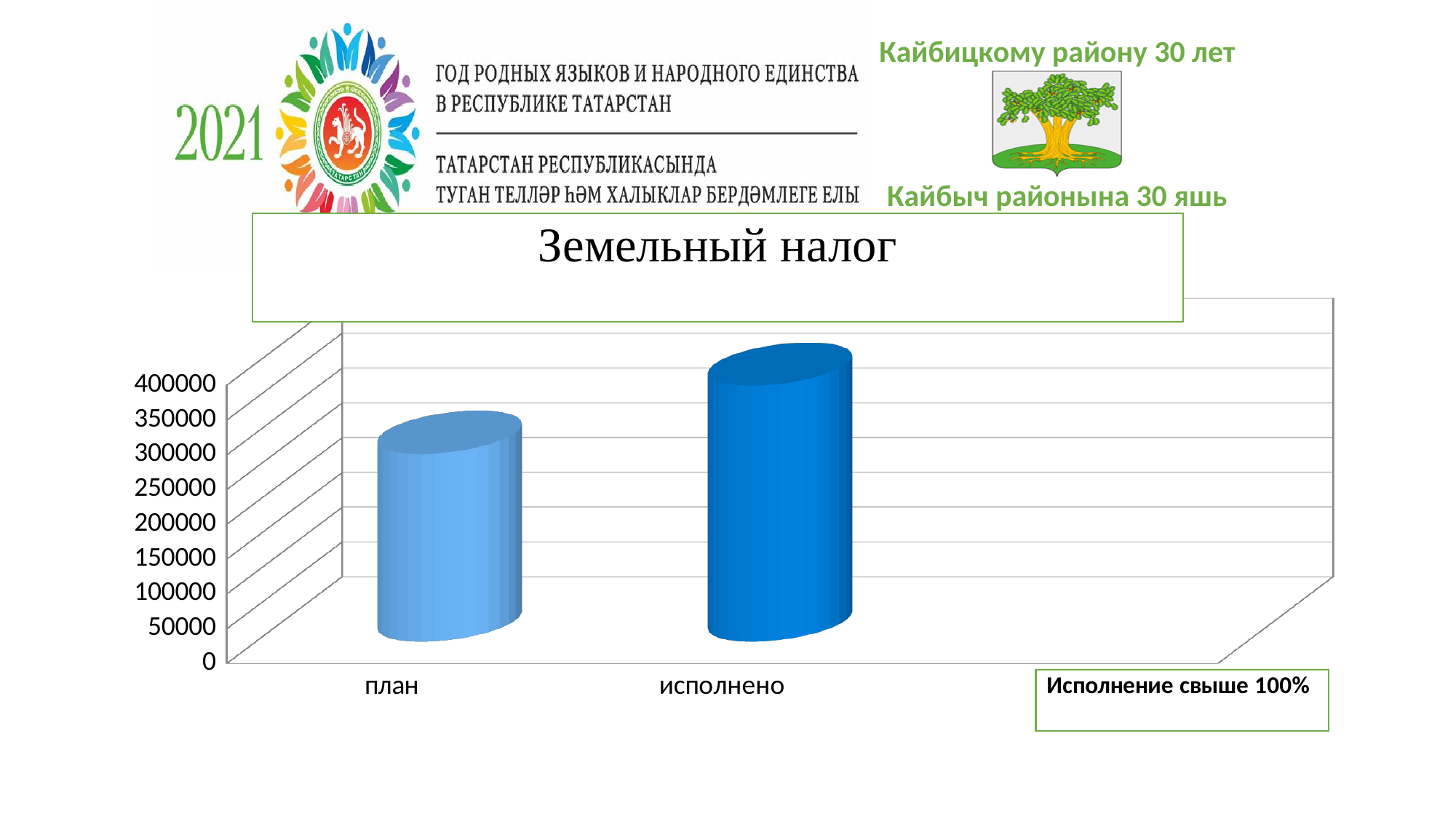
Is the value for план greater or less than 350000? less Is the value for исполнено greater or less than 350000? greater Which category has the higher value, план or исполнено? исполнено Is the value for исполнено greater or less than 300000? greater What kind of chart is shown on the slide? bar chart How many categories are shown on the x axis of the chart? 2 Do the values rise or fall from план to исполнено along the x axis? rise Which category has the highest value in the chart? исполнено What is the title of the chart? Земельный налог Which category has the lowest value in the chart? план What is the highest value shown on the chart's vertical axis? 400000